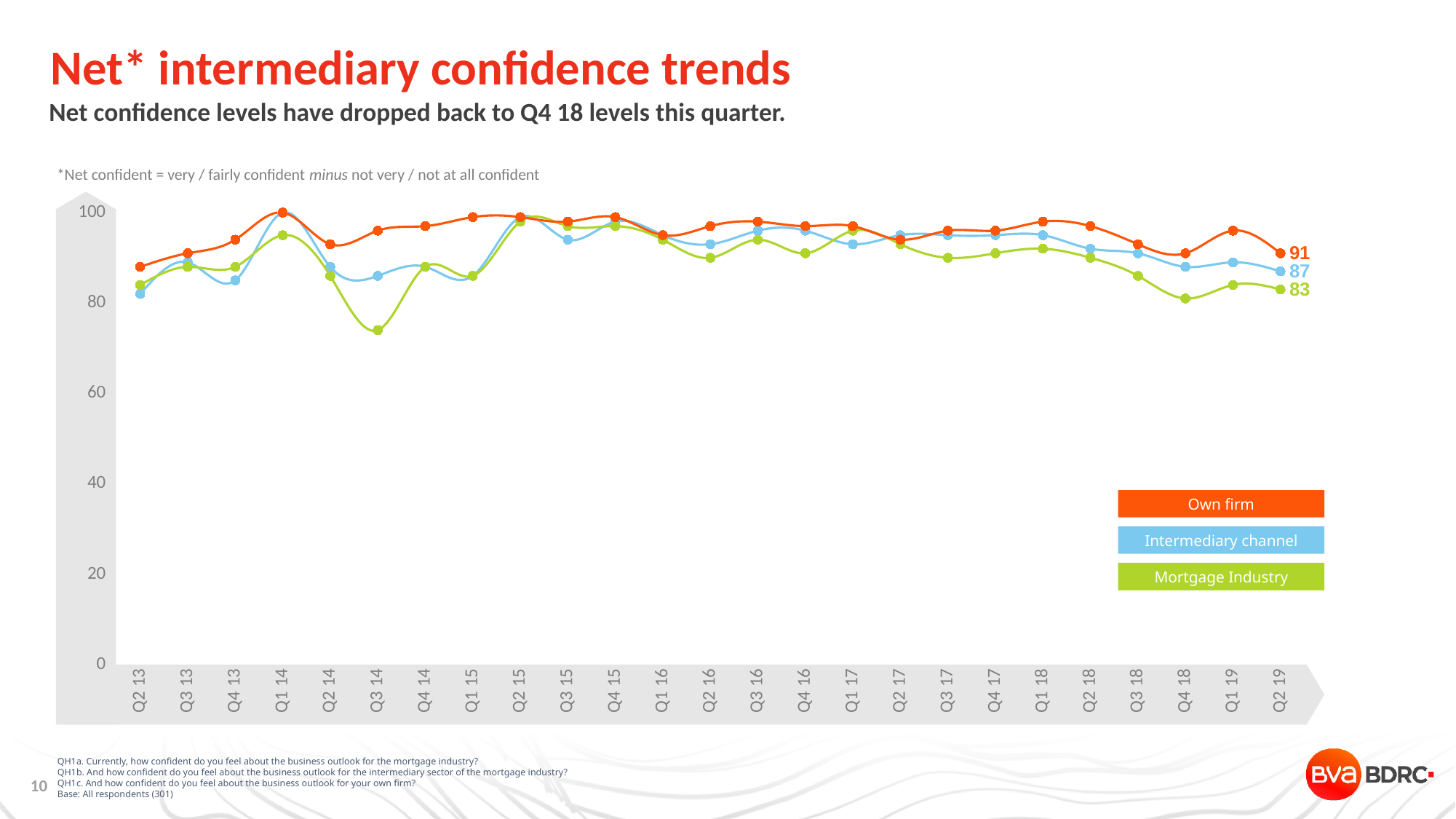
At Q2 19, which is larger: the Intermediary channel value or the Mortgage Industry value? Intermediary channel Which series has the lowest value at Q2 19? Mortgage Industry What is the Own firm value for Q2 19? 91 What is the difference between the Own firm and Mortgage Industry values at Q2 19? 8 How many series does the legend list? 3 Which series has the highest value at Q2 19? Own firm What is the Mortgage Industry value for Q2 19? 83 What is the Intermediary channel value for Q2 19? 87 What kind of chart is shown on the slide? Line chart How many quarters are shown on the x axis? 25 Is the Mortgage Industry value for Q3 14 greater or less than 80? less Is the Own firm value for Q1 14 greater or less than 80? greater